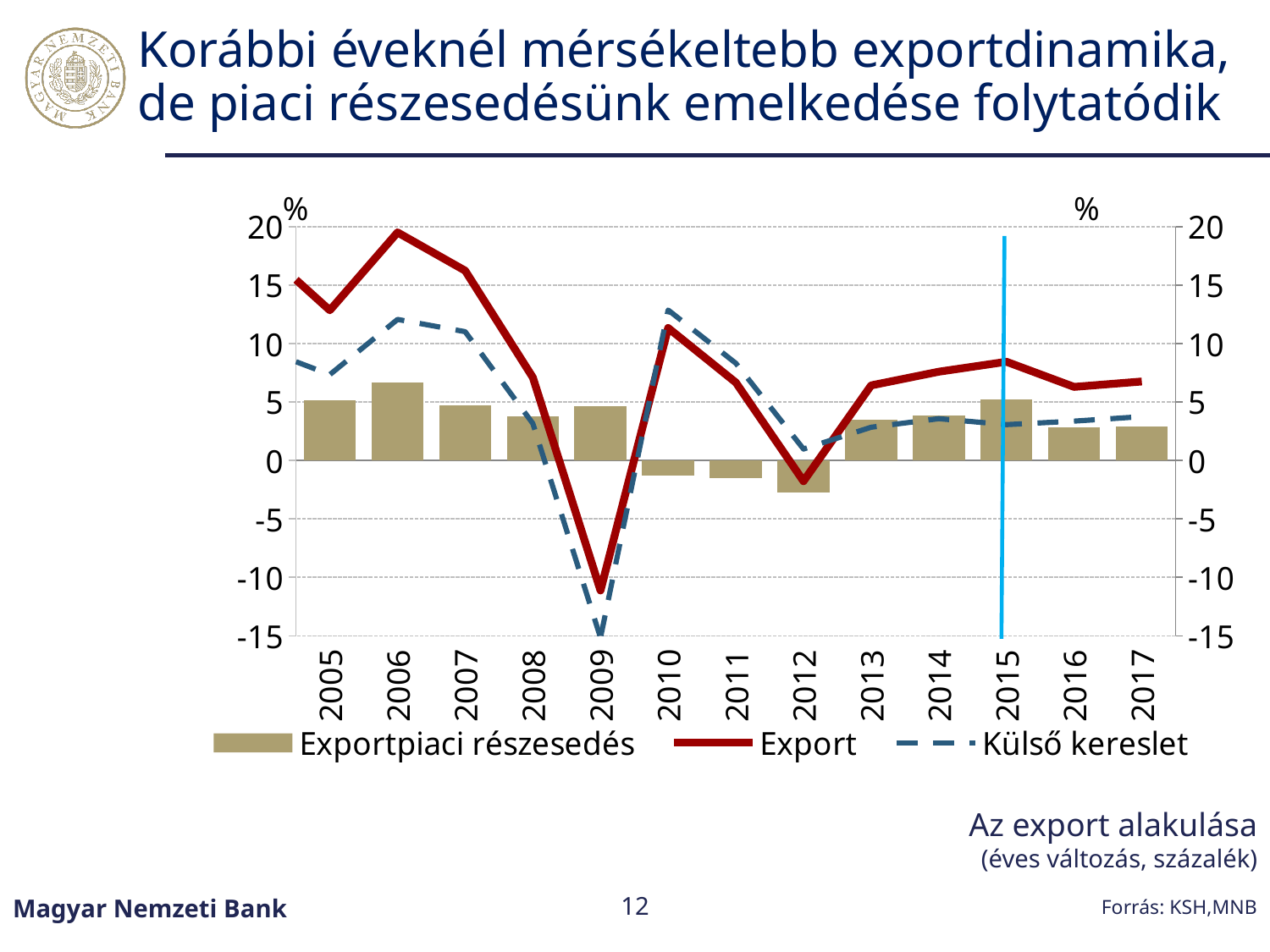
How many years are labelled on the x axis? 13 What kind of chart is shown on the slide? A combined bar and line chart In which year is the Exportpiaci részesedés bar the lowest? 2012 How many series does the legend list? 3 In 2009, which is lower: the Export line or the Külső kereslet line? Külső kereslet Is the value of the Export line in 2006 greater or less than 15? greater In which year does the Export line reach its lowest point? 2009 What is the title given below the chart? Az export alakulása In which year is the Exportpiaci részesedés bar the highest? 2006 Does the Export line rise or fall from 2015 to 2016? It falls In which year does the Export line reach its highest point? 2006 Is the value of the Export line in 2009 greater or less than -10? less